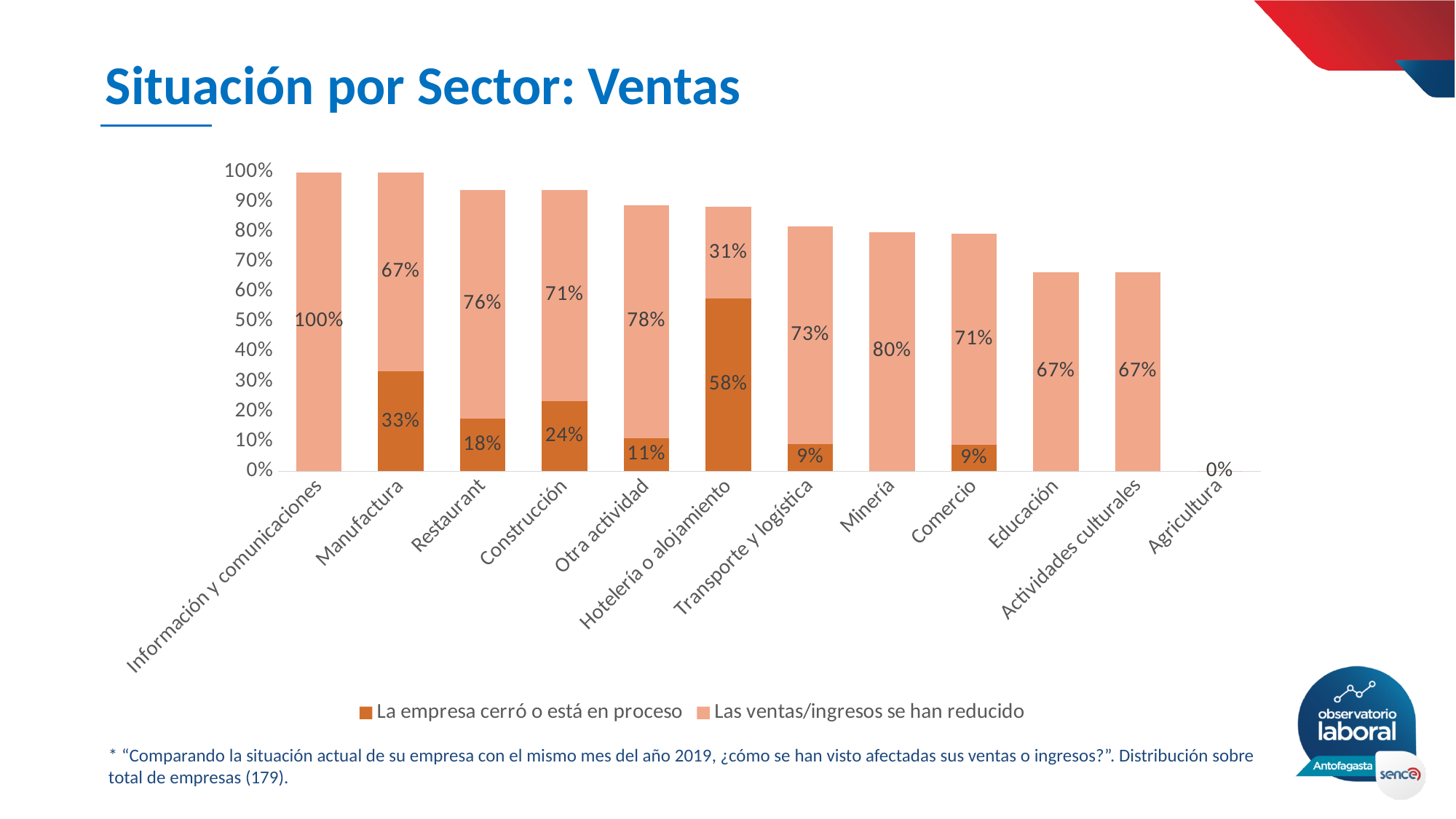
What is the total of the stacked bar for Restaurant? 94% Which sector has the highest value for 'Las ventas/ingresos se han reducido'? Información y comunicaciones Which sector has the highest value for 'La empresa cerró o está en proceso'? Hotelería o alojamiento What is the difference between the 'Las ventas/ingresos se han reducido' values for Otra actividad and Comercio? 7% How many sectors are shown on the x axis? 12 What is the value of 'Las ventas/ingresos se han reducido' for Minería? 80% What value is shown for Agricultura? 0% What is the value of 'La empresa cerró o está en proceso' for Manufactura? 33% Which is larger: the 'La empresa cerró o está en proceso' value for Construcción or for Restaurant? Construcción What kind of chart is shown on the slide? Stacked bar chart How many series does the legend list? 2 What is the value of 'La empresa cerró o está en proceso' for Hotelería o alojamiento? 58%